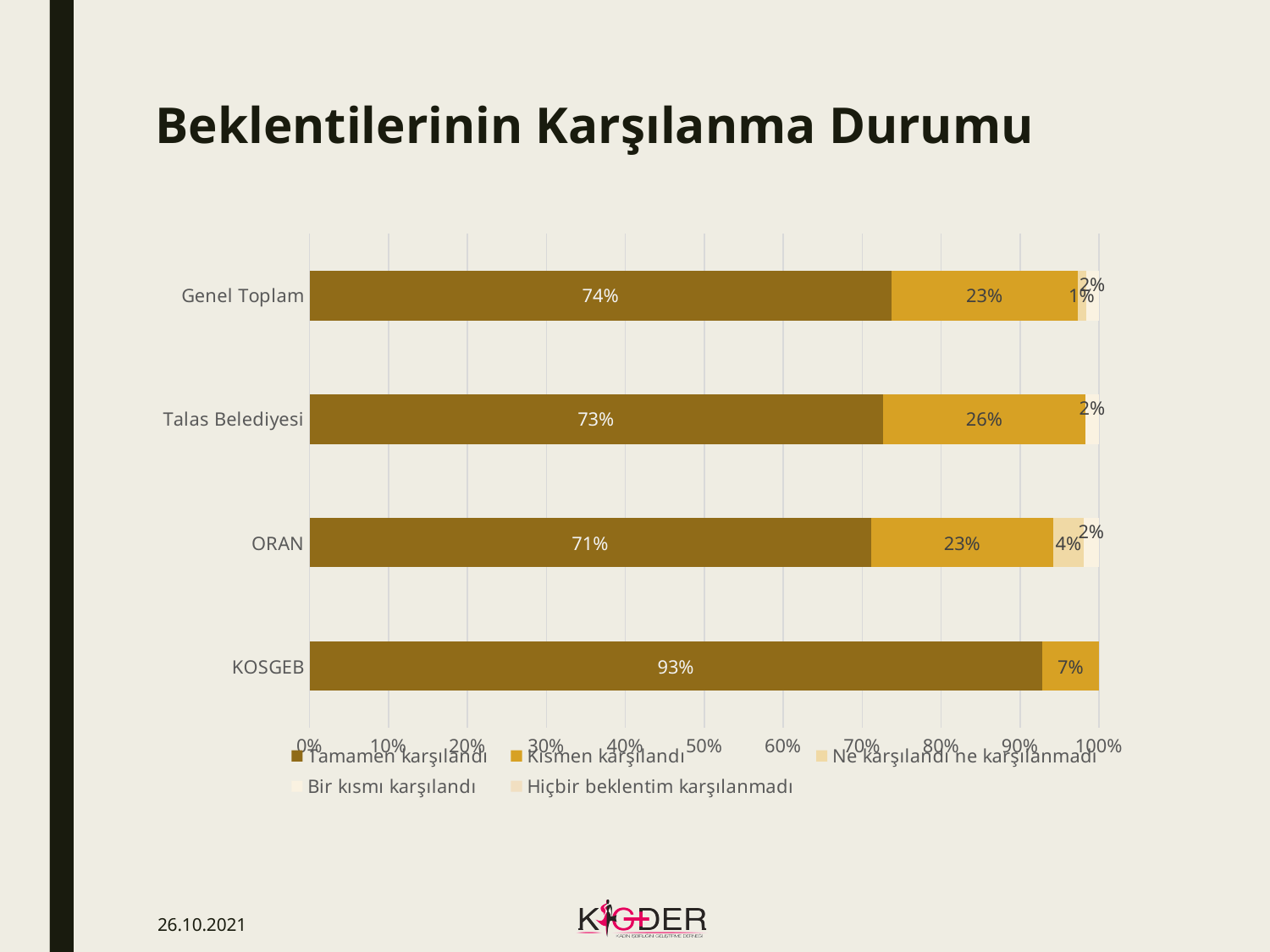
What is the title of the slide? Beklentilerinin Karşılanma Durumu Which has a larger 'Kısmen karşılandı' value, Talas Belediyesi or Genel Toplam? Talas Belediyesi What is the 'Kısmen karşılandı' value for ORAN? 23% What is the 'Tamamen karşılandı' value for Genel Toplam? 74% How many categories are shown on the y axis of the chart? 4 What is the 'Tamamen karşılandı' value for KOSGEB? 93% What kind of chart is shown on the slide? Stacked bar chart Which category has the highest 'Tamamen karşılandı' value? KOSGEB What is the 'Kısmen karşılandı' value for Talas Belediyesi? 26% Which category has the lowest 'Tamamen karşılandı' value? ORAN How many series does the legend list? 5 What is the difference between the 'Tamamen karşılandı' values for KOSGEB and ORAN? 22%